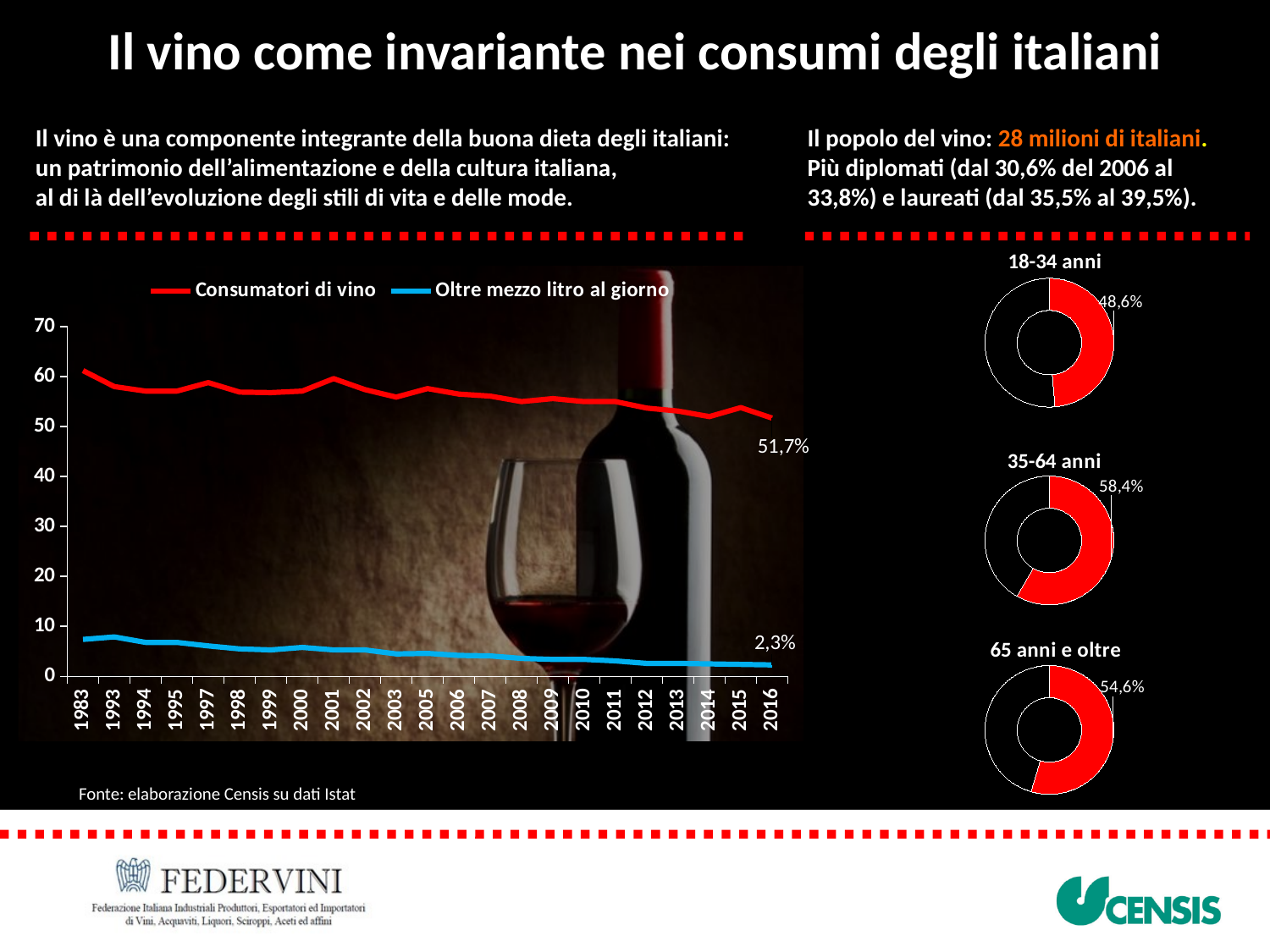
In the donut chart titled 35-64 anni, what percentage is shown? 58,4% In the line chart, is the value for Oltre mezzo litro al giorno in 1983 greater or less than 10? less In the line chart, what is the value for Consumatori di vino in 2016? 51,7% In the donut chart titled 65 anni e oltre, what percentage is shown? 54,6% How many series does the legend of the line chart list? 2 In the line chart, what is the value for Oltre mezzo litro al giorno in 2016? 2,3% What kind of chart is the large chart on the left of the slide? Line chart In the line chart, which series has the higher value in 2016, Consumatori di vino or Oltre mezzo litro al giorno? Consumatori di vino In the donut chart titled 18-34 anni, what percentage is shown? 48,6% Among the three donut charts (18-34 anni, 35-64 anni, 65 anni e oltre), which age group has the highest percentage? 35-64 anni In the line chart, is the value for Consumatori di vino in 1983 greater or less than 60? greater In the line chart, does the Consumatori di vino series rise or fall from 1983 to 2016? Fall